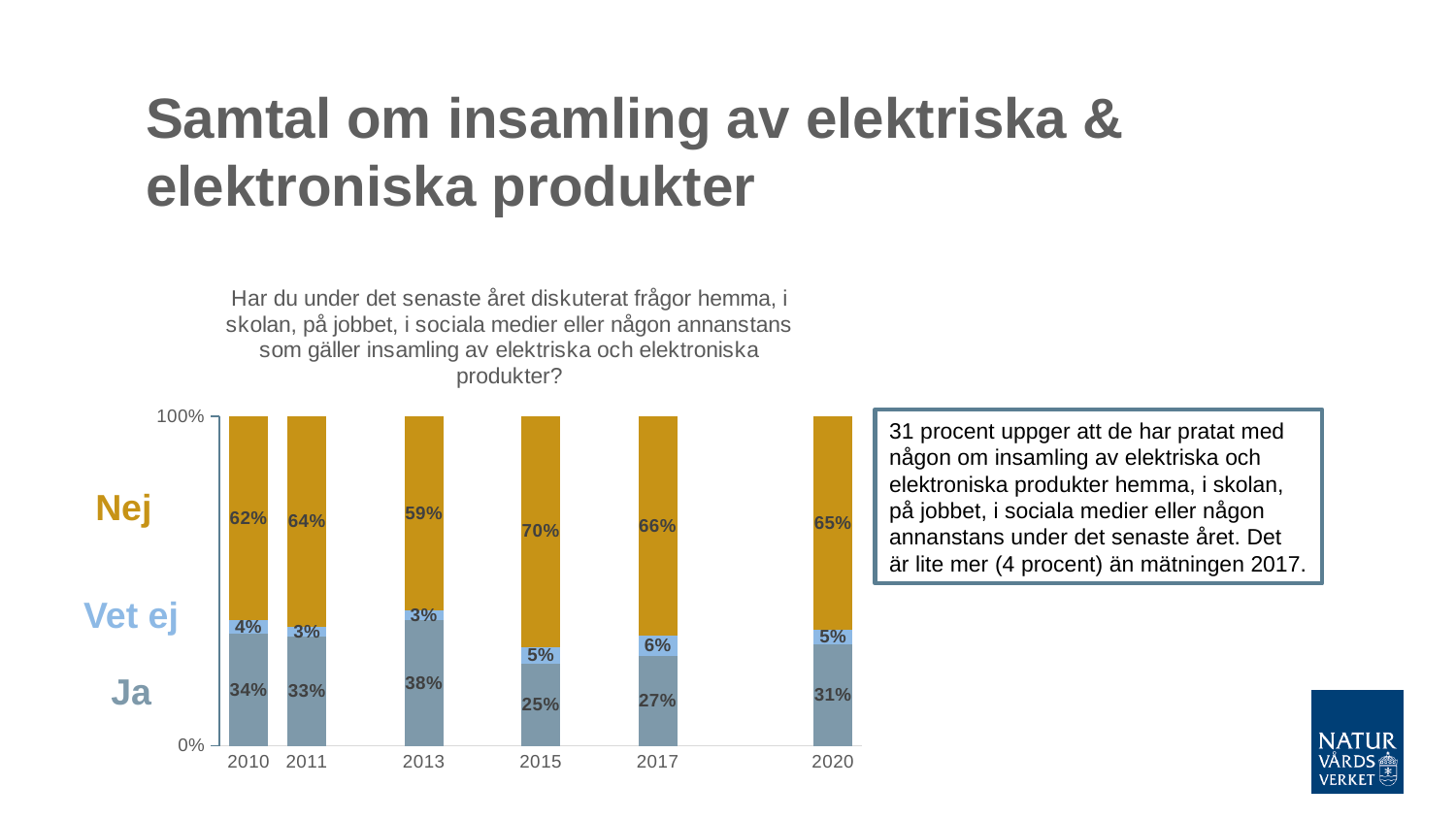
How many series does the chart show (Nej, Vet ej, Ja)? 3 What is the difference between the "Ja" value in 2020 and in 2017? 4% What is the value for "Nej" in 2015? 70% In which year is the "Ja" share highest? 2013 How many years are shown on the x axis of the chart? 6 What is the value for "Ja" in 2020? 31% Which is larger, the "Nej" value in 2011 or in 2013? 2011 What type of chart is shown on the slide? Stacked bar chart Which colour represents the "Nej" series in the chart? Orange What is the total of the stacked bar for 2010 (Ja + Vet ej + Nej)? 100% What is the value for "Vet ej" in 2017? 6% In which year is the "Ja" share lowest? 2015